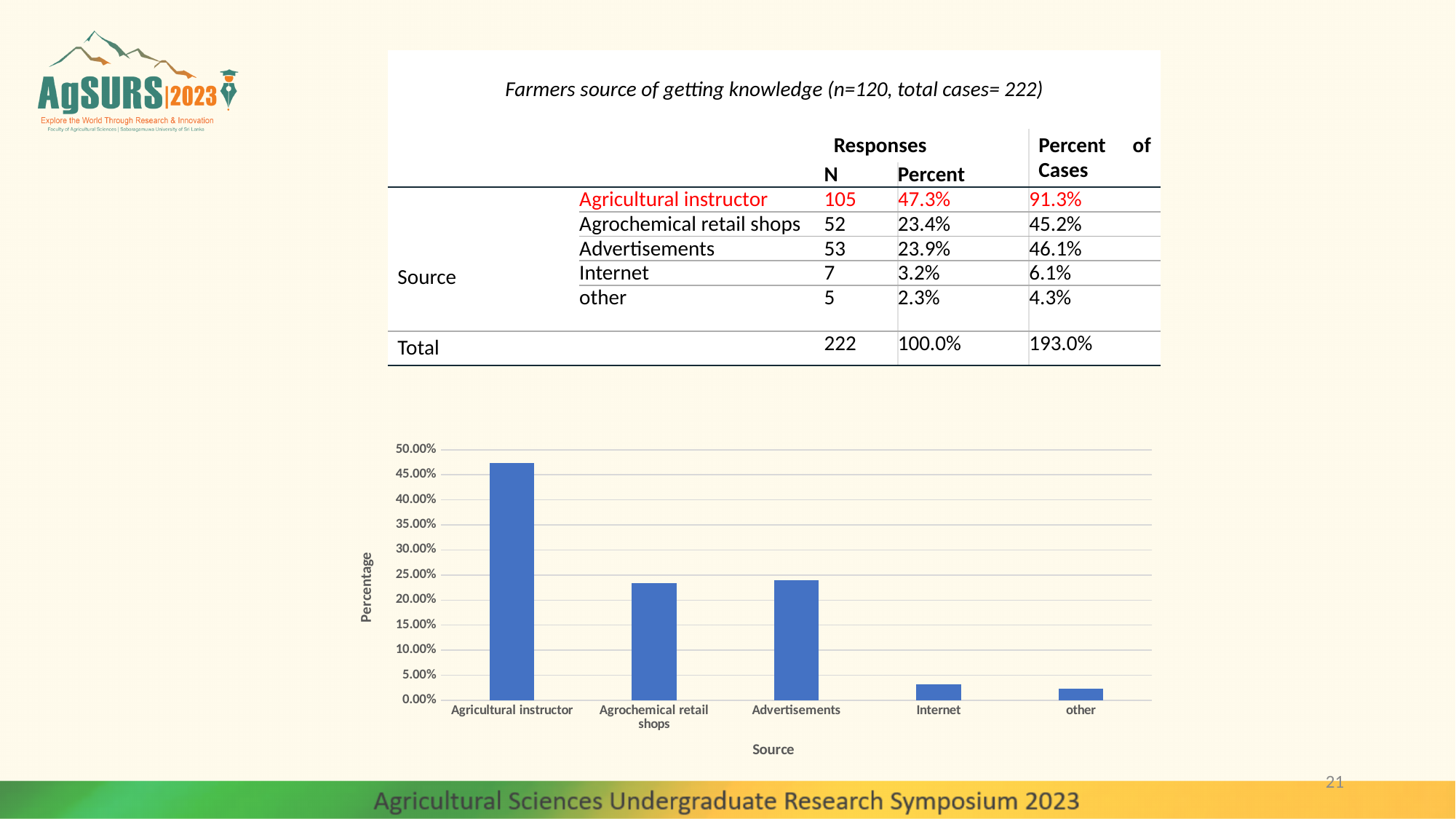
Is the bar for Agricultural instructor greater or less than 45.00%? greater Is the bar for Agrochemical retail shops greater or less than 25.00%? less Which bar is taller, Agricultural instructor or Advertisements? Agricultural instructor According to the table, what percent of responses does Agricultural instructor account for? 47.3% What is the label on the y axis of the bar chart? Percentage Is the bar for Internet greater or less than 5.00%? less Which source has the highest bar in the chart? Agricultural instructor Which bar is taller, Internet or Agrochemical retail shops? Agrochemical retail shops Which source has the lowest bar in the chart? other How many source categories are shown on the x axis of the bar chart? 5 What kind of chart is shown on the slide? bar chart What is the label on the x axis of the bar chart? Source